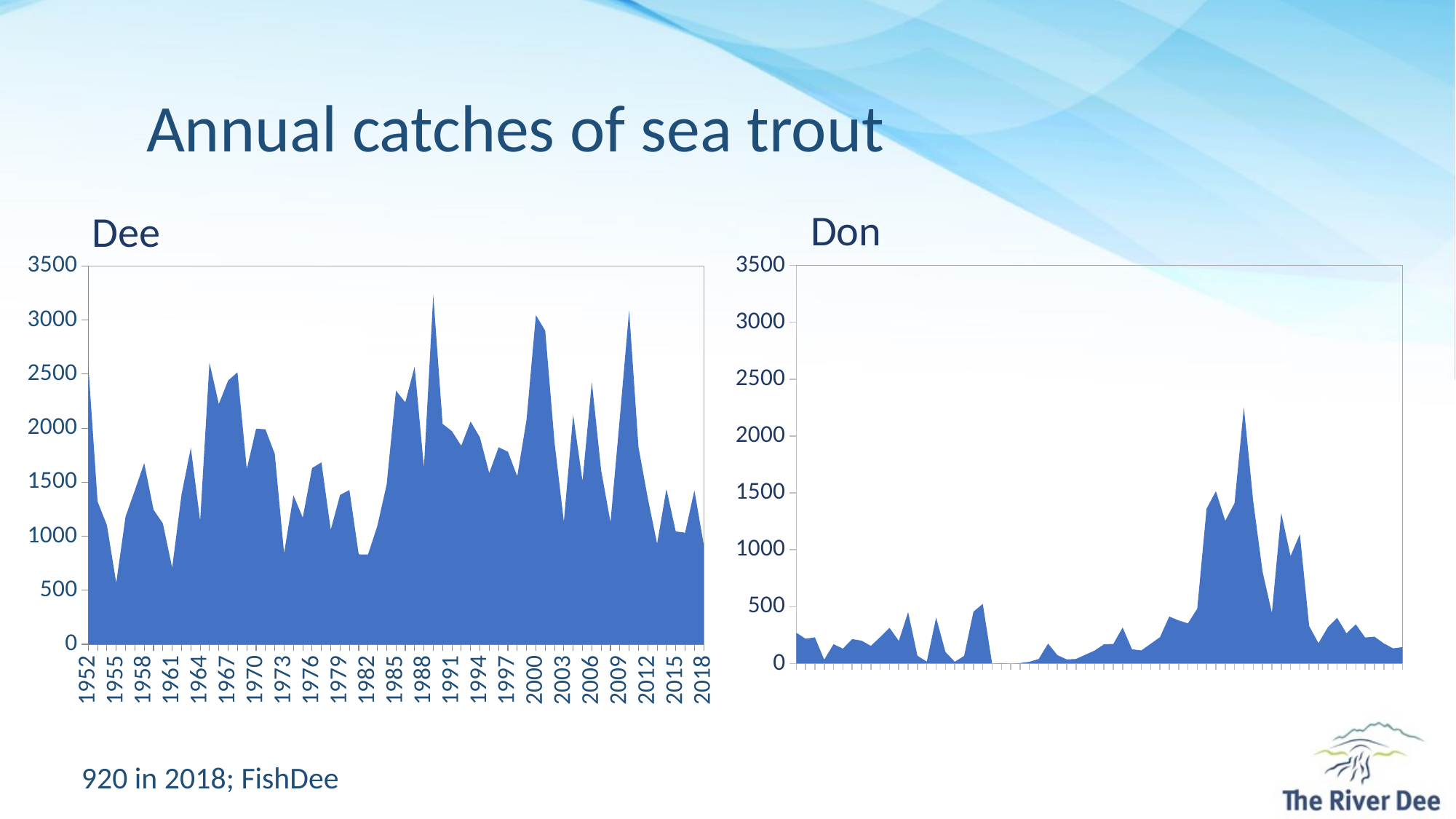
What is the highest value shown on the y axis of the Don chart? 3500 In the Dee chart, is the value for 1955 greater or less than 1000? less In the Dee chart, is the value for 1982 greater or less than 1000? less What kind of chart is the Dee chart? area chart In the Don chart, do the values rise or fall from the highest peak to the right-hand end of the x axis? fall In the Dee chart, is the value for 2018 greater or less than 1000? less What is the title of the slide containing the two charts? Annual catches of sea trout Which chart reaches a higher peak value, Dee or Don? Dee According to the note at the bottom of the slide, what was the Dee catch in 2018? 920